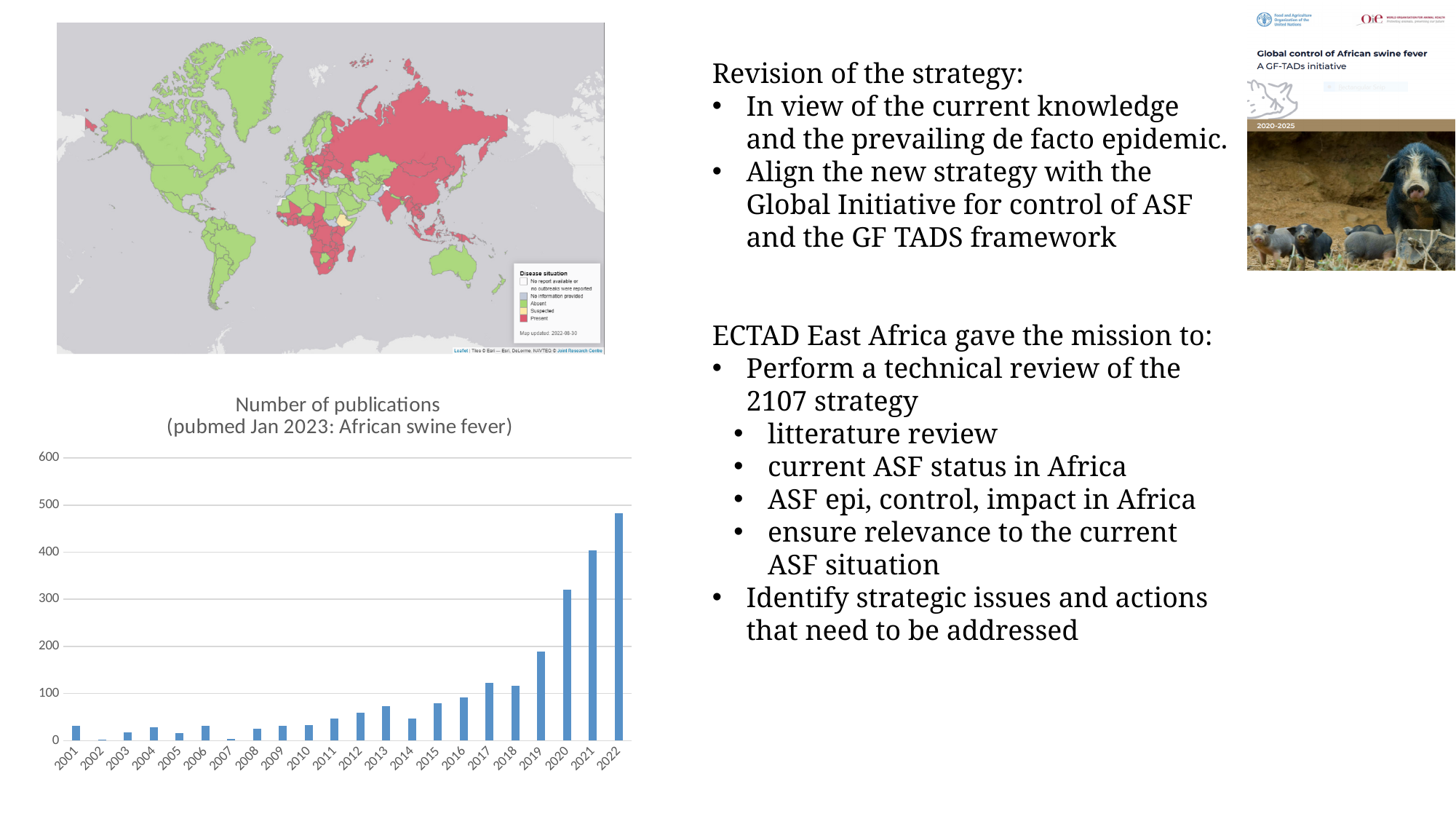
Which year has more publications, 2019 or 2020? 2020 How many years are shown on the x axis of the publications chart? 22 Is the number of publications for 2022 greater or less than 400? greater What kind of chart is shown at the bottom left of the slide? bar chart Which year has more publications, 2021 or 2022? 2022 Is the number of publications for 2019 greater or less than 200? less What is the title of the chart on the slide? Number of publications (pubmed Jan 2023: African swine fever) Which year has the highest number of publications in the chart? 2022 Is the number of publications for 2020 greater or less than 300? greater Overall, do the number of publications rise or fall from 2001 to 2022? rise